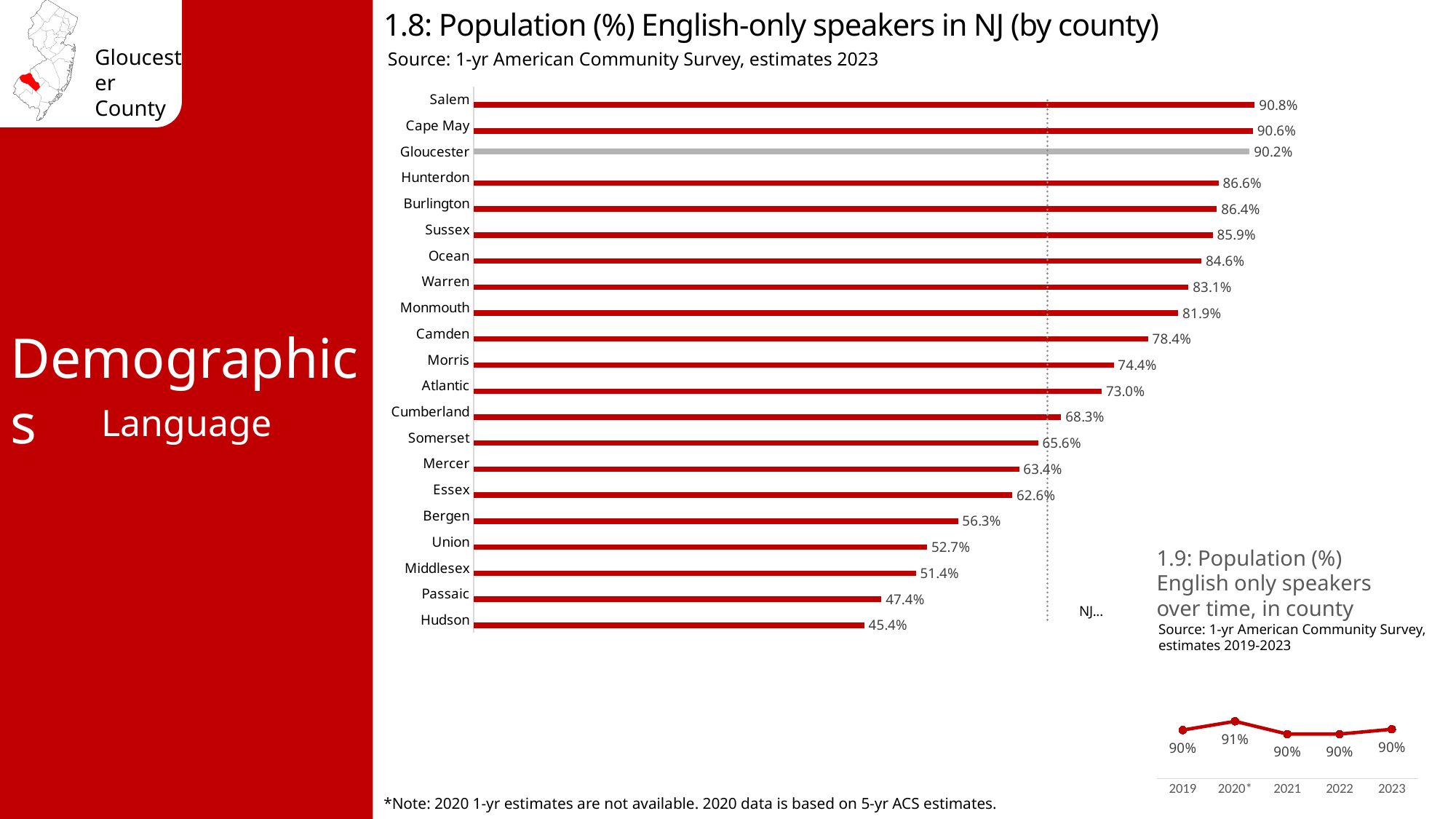
In chart 1.8 (English-only speakers by county), what is the value for Gloucester? 90.2% In chart 1.9 (English only speakers over time, in county), what is the value for 2020*? 91% In chart 1.8 (English-only speakers by county), what is the difference between Gloucester and Cumberland? 21.9% In chart 1.8 (English-only speakers by county), what is the difference between Salem and Hudson? 45.4% In chart 1.8 (English-only speakers by county), how many counties are shown? 21 In chart 1.9 (English only speakers over time, in county), how many years are plotted? 5 In chart 1.8 (English-only speakers by county), which county has the lowest value? Hudson In chart 1.8 (English-only speakers by county), what is the value for Camden? 78.4% In chart 1.8 (English-only speakers by county), which is larger, the value for Bergen or the value for Essex? Essex In chart 1.8 (English-only speakers by county), which county has the highest value? Salem What kind of chart is chart 1.9 (English only speakers over time, in county)? Line chart What kind of chart is chart 1.8 (English-only speakers by county)? Bar chart